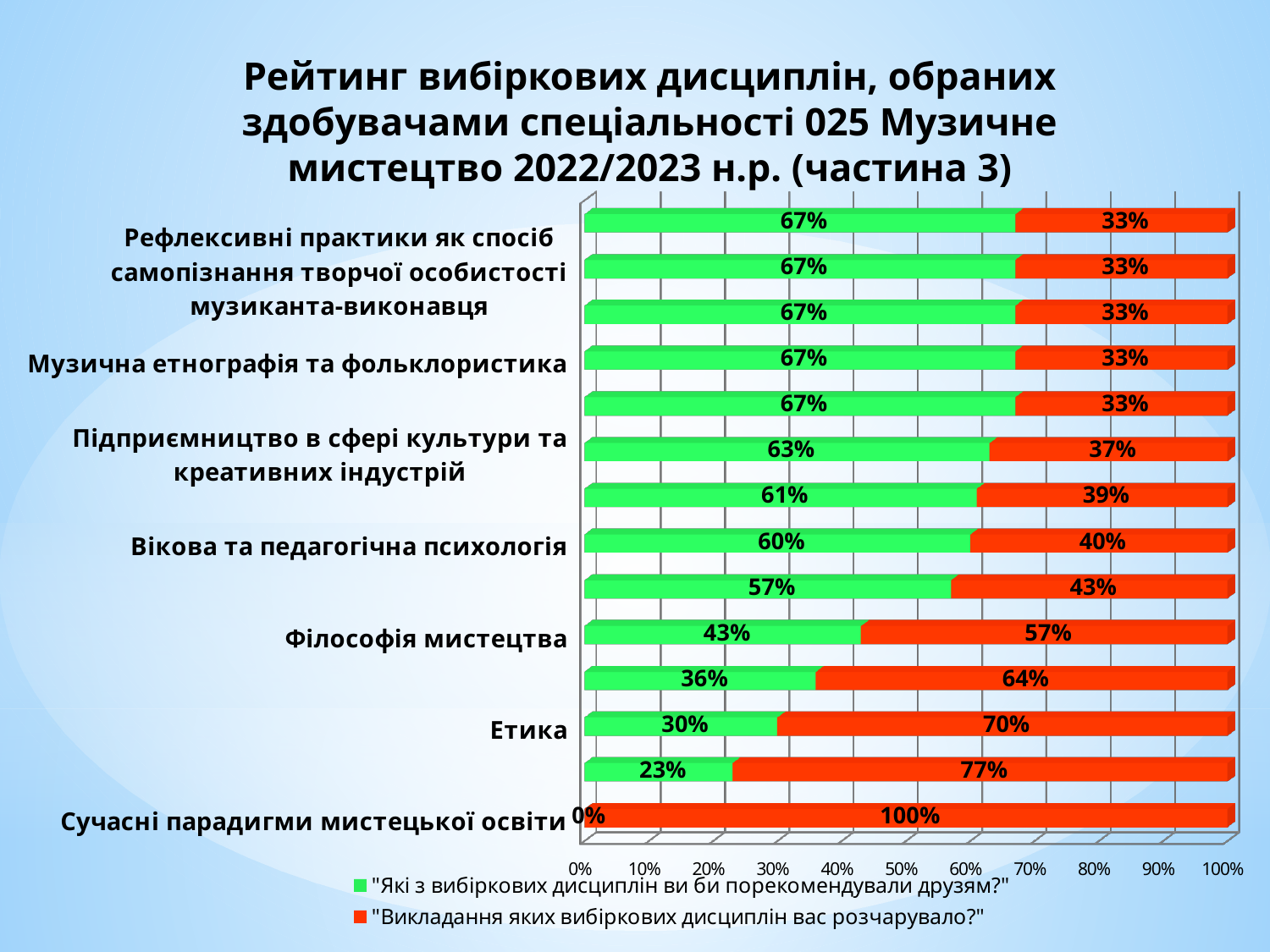
What is the red value for Сучасні парадигми мистецької освіти? 100% What is the green value for Підприємництво в сфері культури та креативних індустрій? 63% What kind of chart is shown on the slide? Stacked bar chart What is the green value for Вікова та педагогічна психологія? 60% What is the green ("порекомендували друзям") value for Етика? 30% What is the red ("розчарувало") value for Філософія мистецтва? 57% What is the total of the stacked bar for Вікова та педагогічна психологія? 100% How many series does the legend list? 2 How many bars are plotted in the chart? 14 Which labeled discipline has the lowest green ("порекомендували друзям") value? Сучасні парадигми мистецької освіти What is the difference between the red and green values for Етика? 40% Which is larger for Музична етнографія та фольклористика: the green value or the red value? The green value (67%)